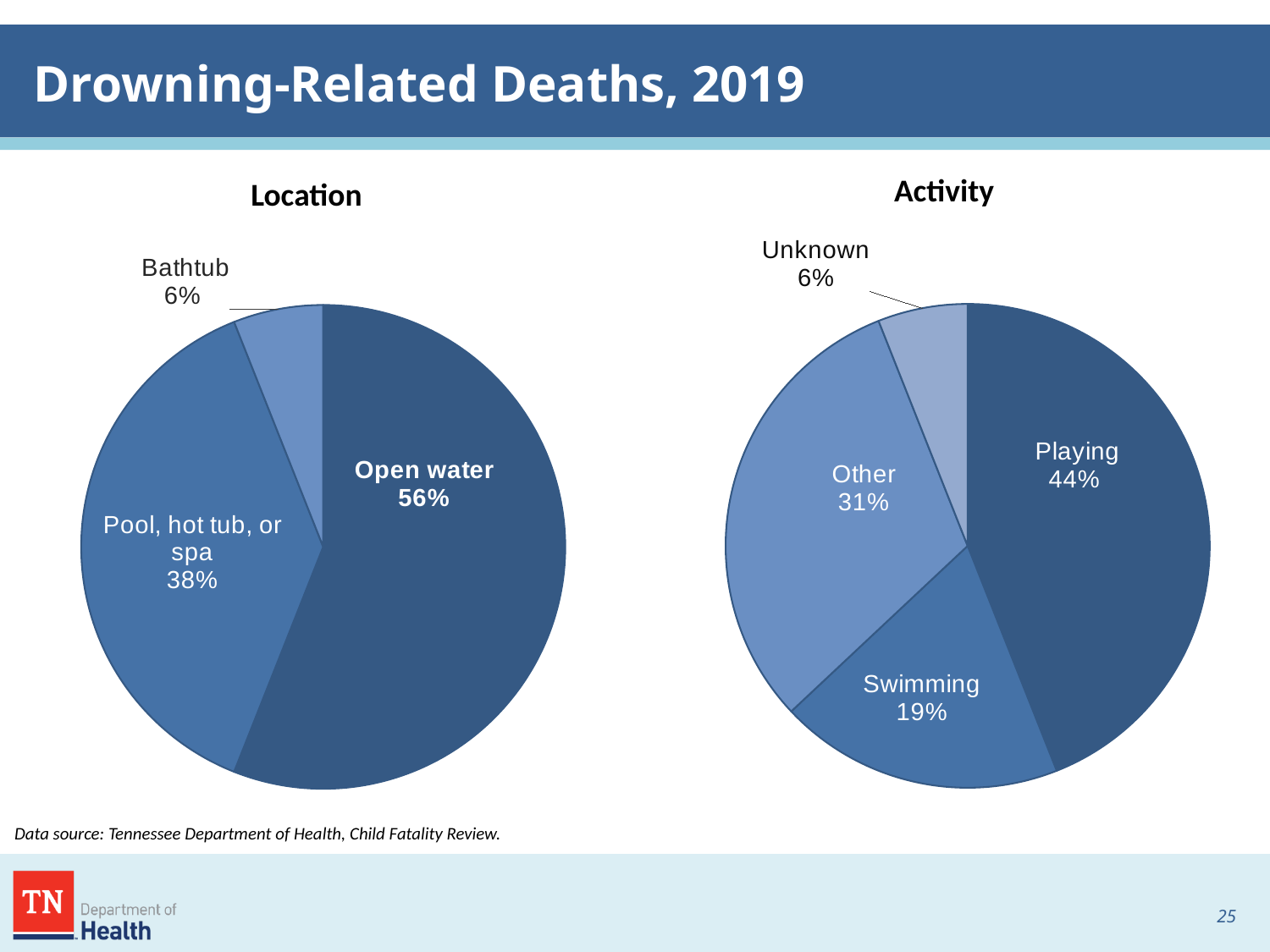
In the Activity pie chart, what share is labelled Other? 31% How many categories are shown in the Activity pie chart? 4 In the Location pie chart, what is the difference in percentage points between Open water and Pool, hot tub, or spa? 18 In the Location pie chart, which location has the smallest share? Bathtub In the Activity pie chart, what percentage of deaths is attributed to Swimming? 19% In the Location pie chart, what percentage is shown for Pool, hot tub, or spa? 38% In the Activity pie chart, which is larger, Other or Swimming? Other How many slices does the Location pie chart have? 3 What type of chart is used for both the Location and Activity charts? Pie chart In the Activity pie chart, which activity has the largest share? Playing In the Location pie chart, what share of drowning-related deaths occurred in open water? 56% In the Activity pie chart, what is the difference in percentage points between Playing and Unknown? 38